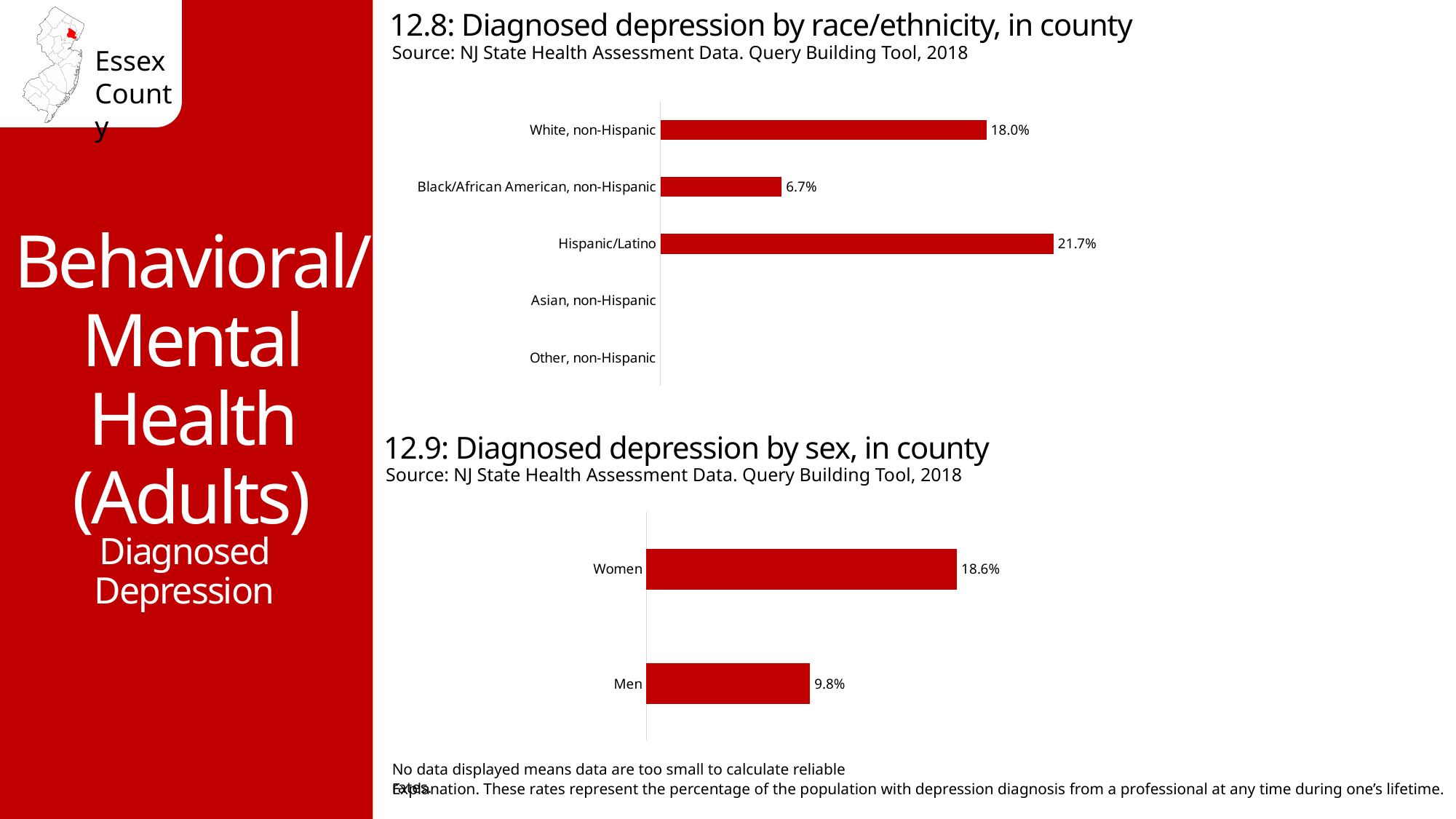
What kind of chart is '12.9: Diagnosed depression by sex, in county'? Bar chart In the chart '12.8: Diagnosed depression by race/ethnicity, in county', which category has the highest value? Hispanic/Latino In the chart '12.8: Diagnosed depression by race/ethnicity, in county', what is the value for White, non-Hispanic? 18.0% In the chart '12.8: Diagnosed depression by race/ethnicity, in county', what is the value for Hispanic/Latino? 21.7% In the chart '12.8: Diagnosed depression by race/ethnicity, in county', which category with a displayed bar has the lowest value? Black/African American, non-Hispanic In the chart '12.9: Diagnosed depression by sex, in county', what is the difference between the Women and Men values? 8.8% In the chart '12.8: Diagnosed depression by race/ethnicity, in county', which categories have no bar displayed? Asian, non-Hispanic and Other, non-Hispanic In the chart '12.8: Diagnosed depression by race/ethnicity, in county', what is the value for Black/African American, non-Hispanic? 6.7% In the chart '12.9: Diagnosed depression by sex, in county', what is the value for Women? 18.6% In the chart '12.9: Diagnosed depression by sex, in county', what is the value for Men? 9.8% In the chart '12.8: Diagnosed depression by race/ethnicity, in county', what is the difference between the Hispanic/Latino and White, non-Hispanic values? 3.7% In the chart '12.8: Diagnosed depression by race/ethnicity, in county', how many categories are listed on the axis? 5